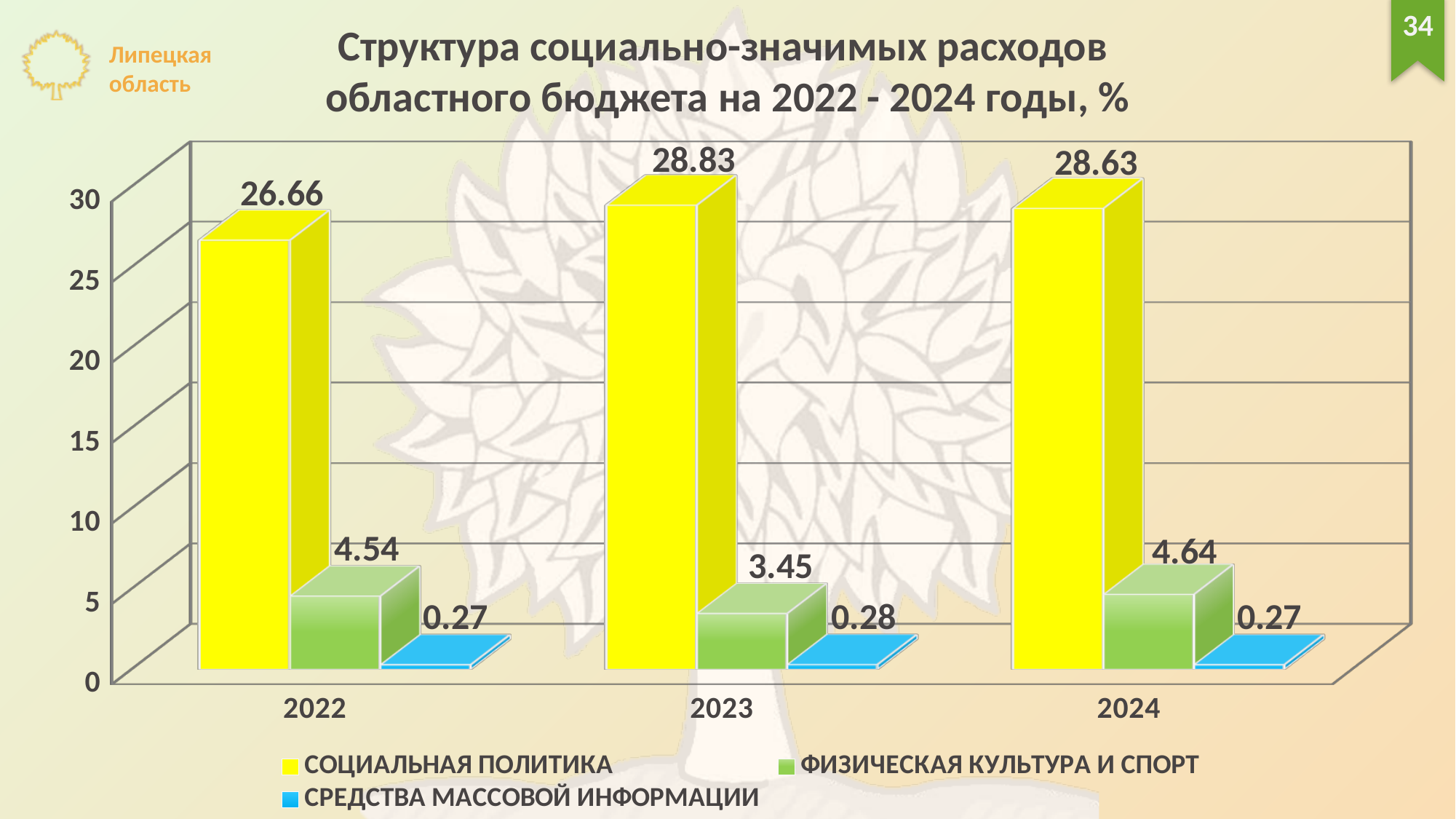
What is the value for СОЦИАЛЬНАЯ ПОЛИТИКА in 2023? 28.83 How many series does the legend list? 3 What is the difference between the СОЦИАЛЬНАЯ ПОЛИТИКА values for 2023 and 2022? 2.17 In which year is the value for СОЦИАЛЬНАЯ ПОЛИТИКА highest? 2023 What is the value for ФИЗИЧЕСКАЯ КУЛЬТУРА И СПОРТ in 2022? 4.54 Is the value for СОЦИАЛЬНАЯ ПОЛИТИКА in 2022 greater or less than 25? greater How many years are shown on the x axis? 3 What kind of chart is shown on the slide? bar chart In which year is the value for ФИЗИЧЕСКАЯ КУЛЬТУРА И СПОРТ lowest? 2023 Which is larger: ФИЗИЧЕСКАЯ КУЛЬТУРА И СПОРТ in 2024 or in 2022? 2024 Which colour represents СРЕДСТВА МАССОВОЙ ИНФОРМАЦИИ in the chart? blue What is the value for СРЕДСТВА МАССОВОЙ ИНФОРМАЦИИ in 2023? 0.28